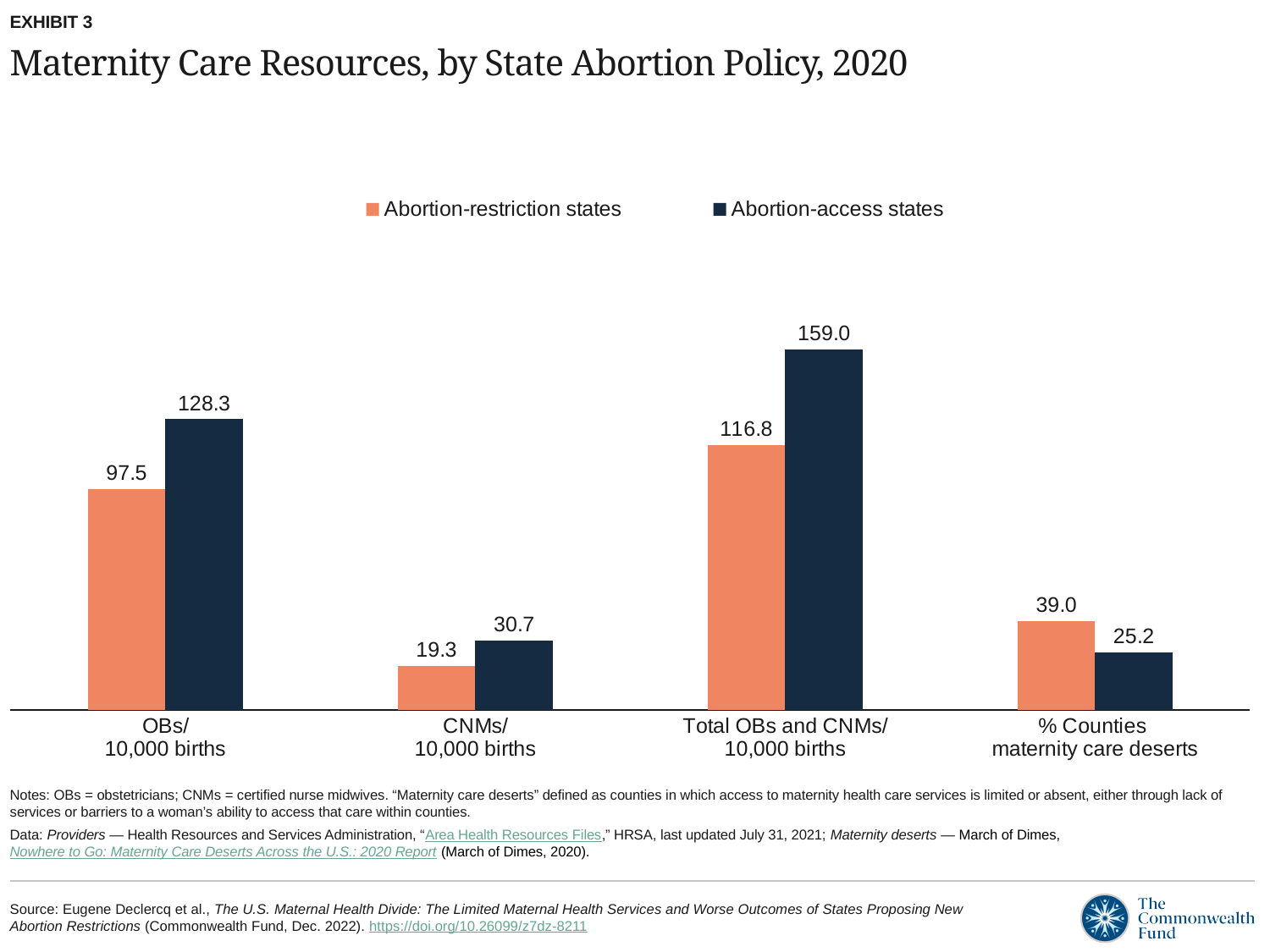
What is the value for OBs/10,000 births in abortion-restriction states? 97.5 What is the value for CNMs/10,000 births in abortion-access states? 30.7 For % Counties maternity care deserts, which group has the larger value: abortion-restriction states or abortion-access states? Abortion-restriction states What is the difference between abortion-access states and abortion-restriction states for OBs/10,000 births? 30.8 Which category has the highest value for abortion-access states? Total OBs and CNMs/10,000 births Which category has the lowest value for abortion-restriction states? CNMs/10,000 births What is the value for OBs/10,000 births in abortion-access states? 128.3 How many categories are shown on the x axis? 4 What percentage of counties are maternity care deserts in abortion-restriction states? 39.0 How many series does the legend list? 2 What is the difference between abortion-access states and abortion-restriction states for Total OBs and CNMs/10,000 births? 42.2 What kind of chart is shown on the slide? Bar chart